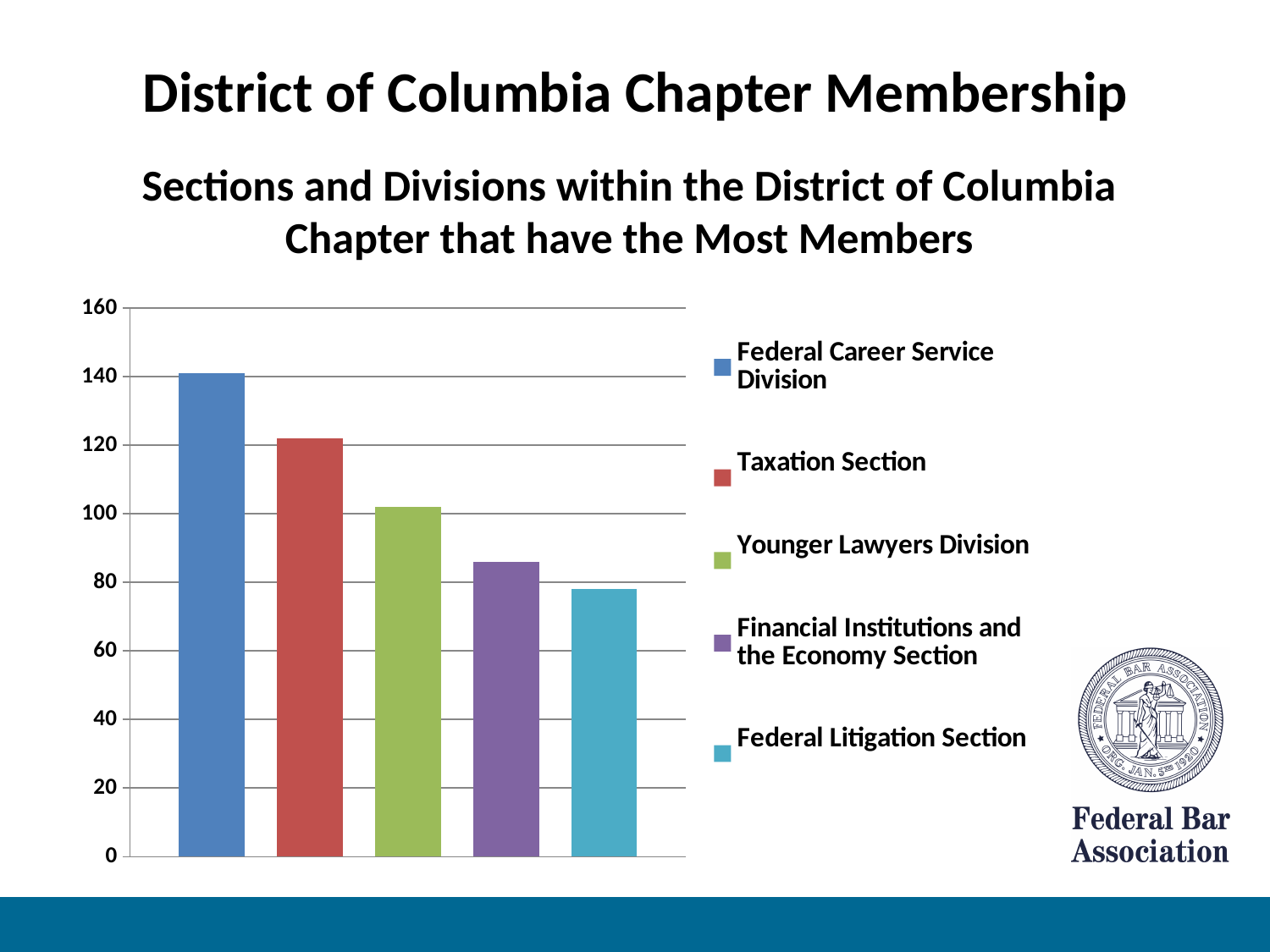
Is the value for the Taxation Section greater or less than 140? less Do the bar values rise or fall from left to right across the chart? fall Which has more members, the Taxation Section or the Younger Lawyers Division? Taxation Section Which has more members, the Financial Institutions and the Economy Section or the Federal Career Service Division? Federal Career Service Division Is the value for the Financial Institutions and the Economy Section greater or less than 100? less Which section or division has the lowest membership in the chart? Federal Litigation Section How many entries does the chart's legend list? 5 What kind of chart is shown on the slide? bar chart Which section or division has the highest membership in the chart? Federal Career Service Division Is the value for the Younger Lawyers Division greater or less than 120? less How many bars are plotted in the chart? 5